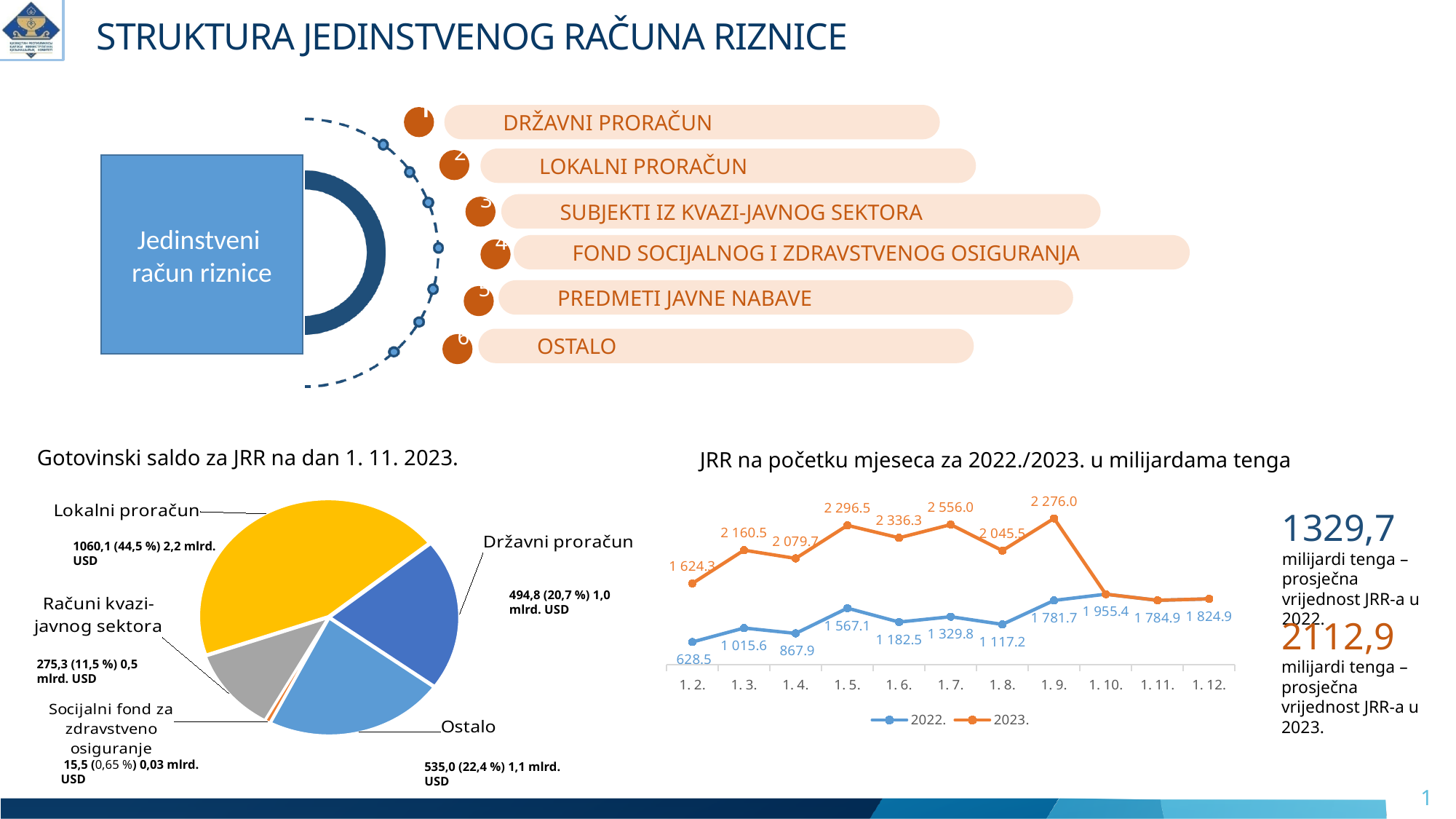
What kind of chart is 'JRR na početku mjeseca za 2022./2023. u milijardama tenga'? line chart How many series does the legend of the chart 'JRR na početku mjeseca za 2022./2023. u milijardama tenga' list? 2 In the chart 'JRR na početku mjeseca za 2022./2023. u milijardama tenga', what is the difference between the 2023. and 2022. values at 1. 5.? 729.4 In the chart 'JRR na početku mjeseca za 2022./2023. u milijardama tenga', at which month is the 2023. series highest? 1. 7. In the pie chart 'Gotovinski saldo za JRR na dan 1. 11. 2023.', which slice is the largest? Lokalni proračun What kind of chart is 'Gotovinski saldo za JRR na dan 1. 11. 2023.'? pie chart In the chart 'JRR na početku mjeseca za 2022./2023. u milijardama tenga', what is the 2023. value at 1. 7.? 2 556.0 In the pie chart 'Gotovinski saldo za JRR na dan 1. 11. 2023.', what value is shown for Ostalo? 535,0 (22,4 %) In the chart 'JRR na početku mjeseca za 2022./2023. u milijardama tenga', what is the 2022. value at 1. 2.? 628.5 In the pie chart 'Gotovinski saldo za JRR na dan 1. 11. 2023.', what share does Lokalni proračun have? 44,5 % In the pie chart 'Gotovinski saldo za JRR na dan 1. 11. 2023.', which slice is the smallest? Socijalni fond za zdravstveno osiguranje How many slices does the pie chart 'Gotovinski saldo za JRR na dan 1. 11. 2023.' have? 5